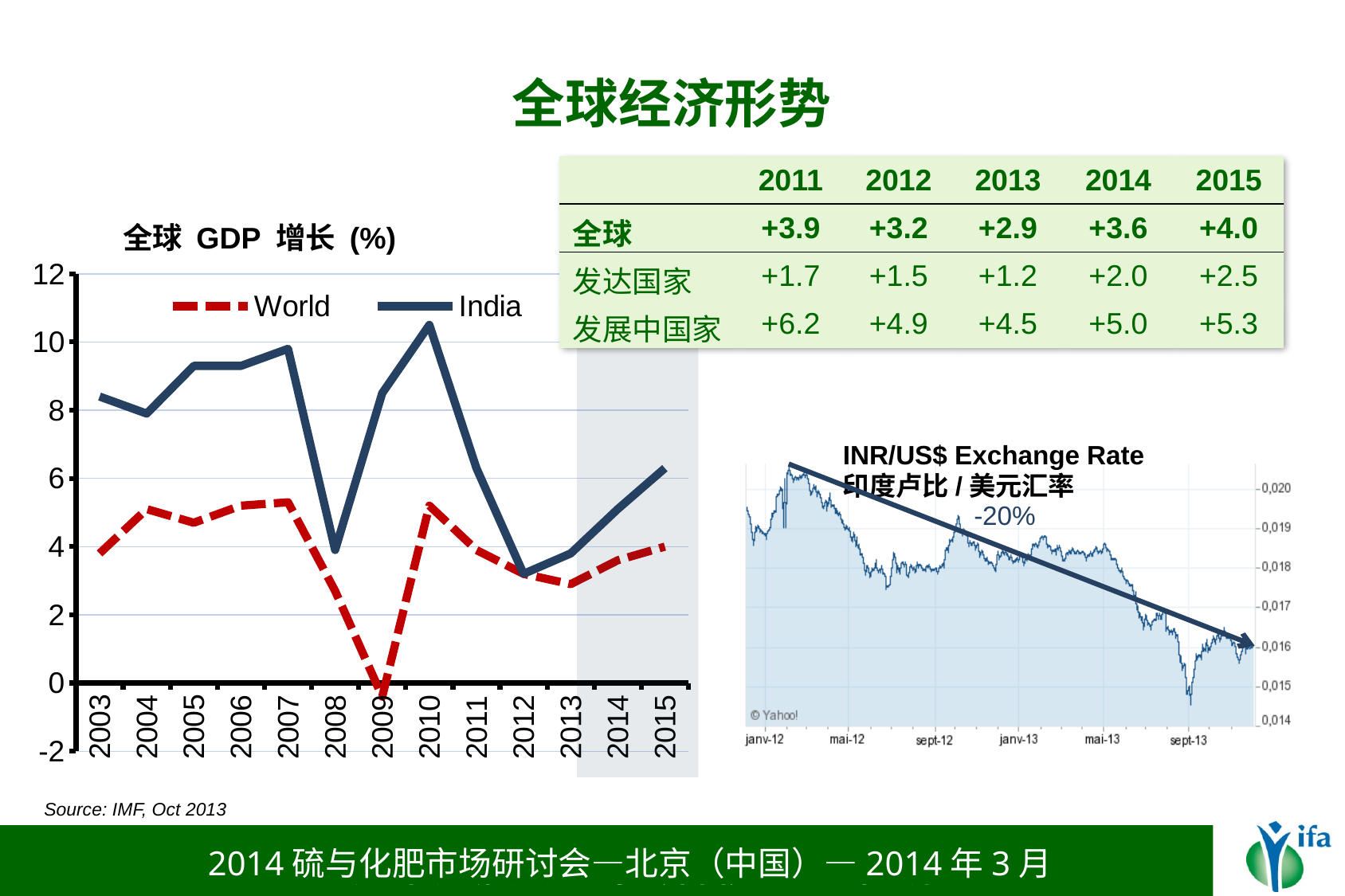
What percentage change is annotated on the INR/US$ Exchange Rate chart? -20% How many series does the legend of the 全球 GDP 增长 (%) chart list? 2 In the 全球 GDP 增长 (%) chart, is the India value for 2010 greater or less than 10? greater In the 全球 GDP 增长 (%) chart, is the World value for 2009 greater or less than 0? less In the 全球 GDP 增长 (%) chart, is the India value for 2008 greater or less than 6? less Which two series are shown in the legend of the 全球 GDP 增长 (%) chart? World and India What kind of chart is the 全球 GDP 增长 (%) chart? line chart In the 全球 GDP 增长 (%) chart, in which year does the World series reach its lowest value? 2009 In the INR/US$ Exchange Rate chart, does the exchange rate rise or fall overall from janv-12 to the end of the period? fall In the 全球 GDP 增长 (%) chart, in which year does the India series reach its highest value? 2010 In the 全球 GDP 增长 (%) chart, which series has the larger value in 2015, World or India? India How many years are shown on the x axis of the 全球 GDP 增长 (%) chart? 13